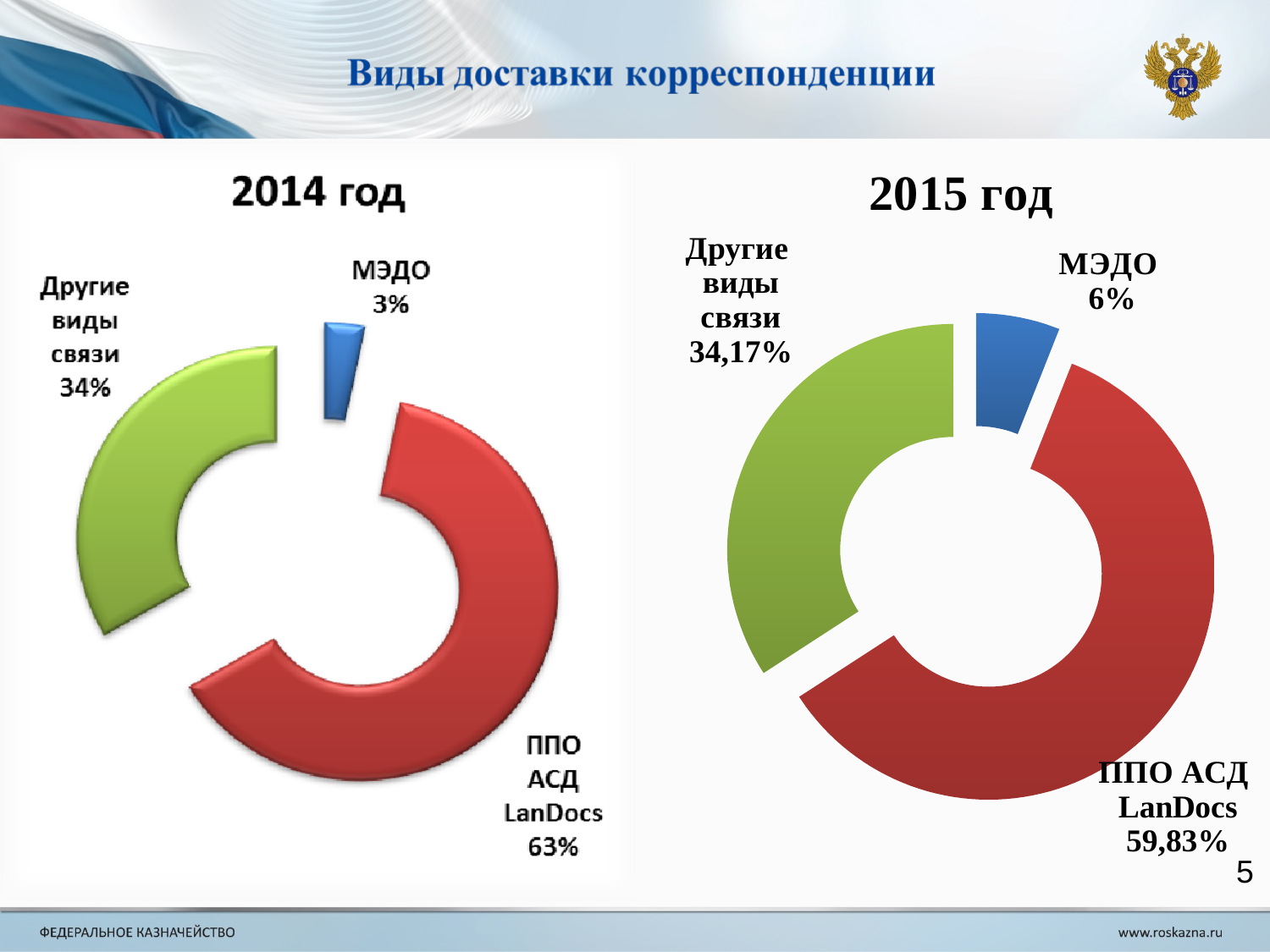
In the 2015 год chart, what colour is the МЭДО slice? Blue What kind of chart is the 2014 год chart? Doughnut (pie) chart What is the title of the slide? Виды доставки корреспонденции How many categories are shown in the 2015 год chart? 3 In the 2015 год chart, what share does ППО АСД LanDocs have? 59,83% In the 2014 год chart, what share does МЭДО have? 3% In the 2015 год chart, what share does Другие виды связи have? 34,17% In the 2015 год chart, which category has the largest share? ППО АСД LanDocs In the 2015 год chart, which is larger: the share of МЭДО or the share of Другие виды связи? Другие виды связи In the 2014 год chart, which category has the smallest share? МЭДО In the 2014 год chart, what is the difference between the shares of ППО АСД LanDocs and Другие виды связи? 29% In the 2014 год chart, what share does ППО АСД LanDocs have? 63%